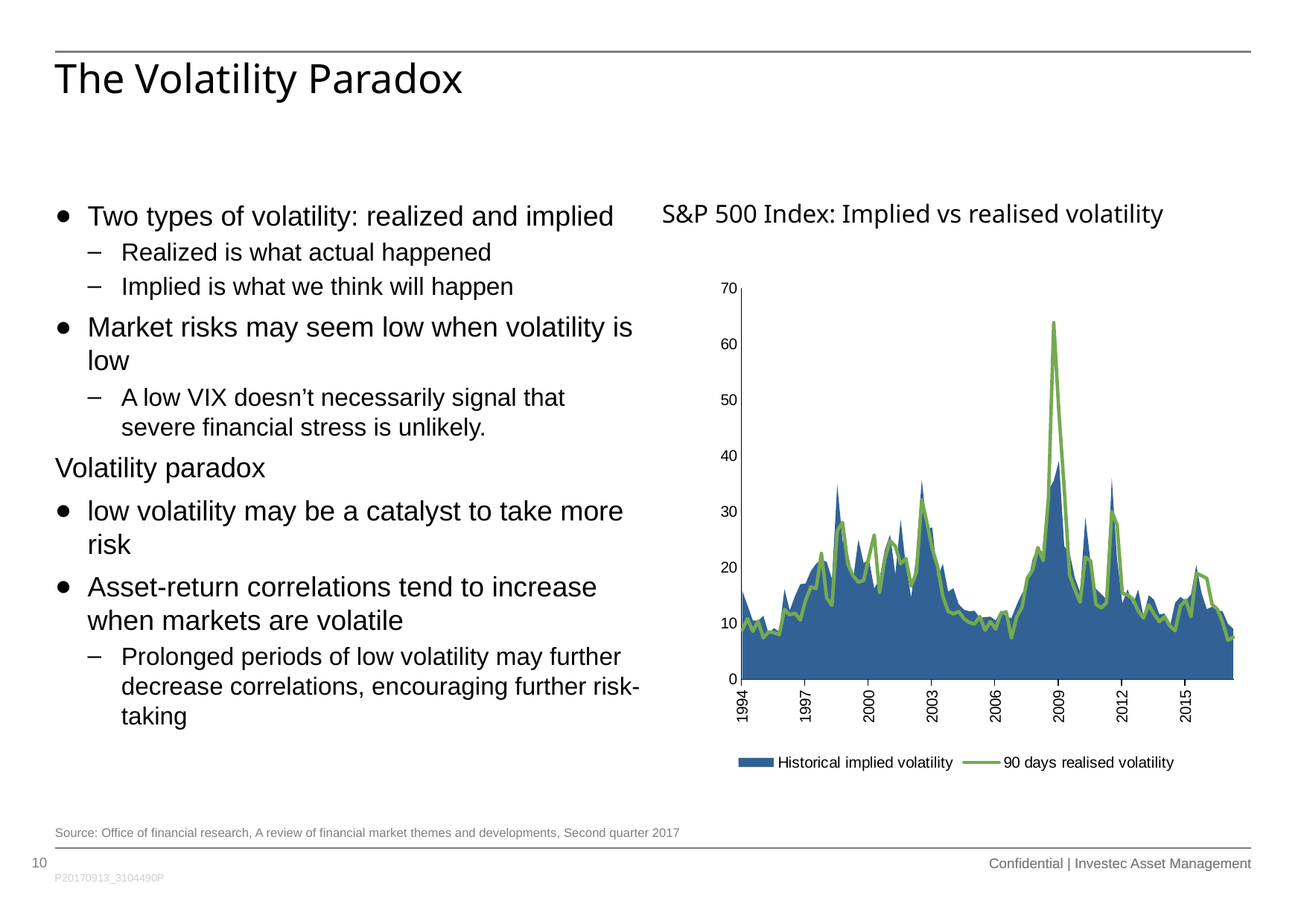
Is the peak value of the Historical implied volatility around 2009 greater or less than 50? less What kind of chart is shown on the slide? A combined area and line chart How many series does the legend list? 2 What is the title of the chart? S&P 500 Index: Implied vs realised volatility Is the Historical implied volatility at the start of 1994 greater or less than 20? less Is the peak value of the 90 days realised volatility around 2009 greater or less than 60? greater Do the volatility values rise or fall from the 2009 peak to 2015? fall How many year labels are shown on the x axis? 8 Around which labelled year does the 90 days realised volatility reach its highest value? 2009 What is the highest value shown on the y axis? 70 Which series is drawn as a green line? 90 days realised volatility